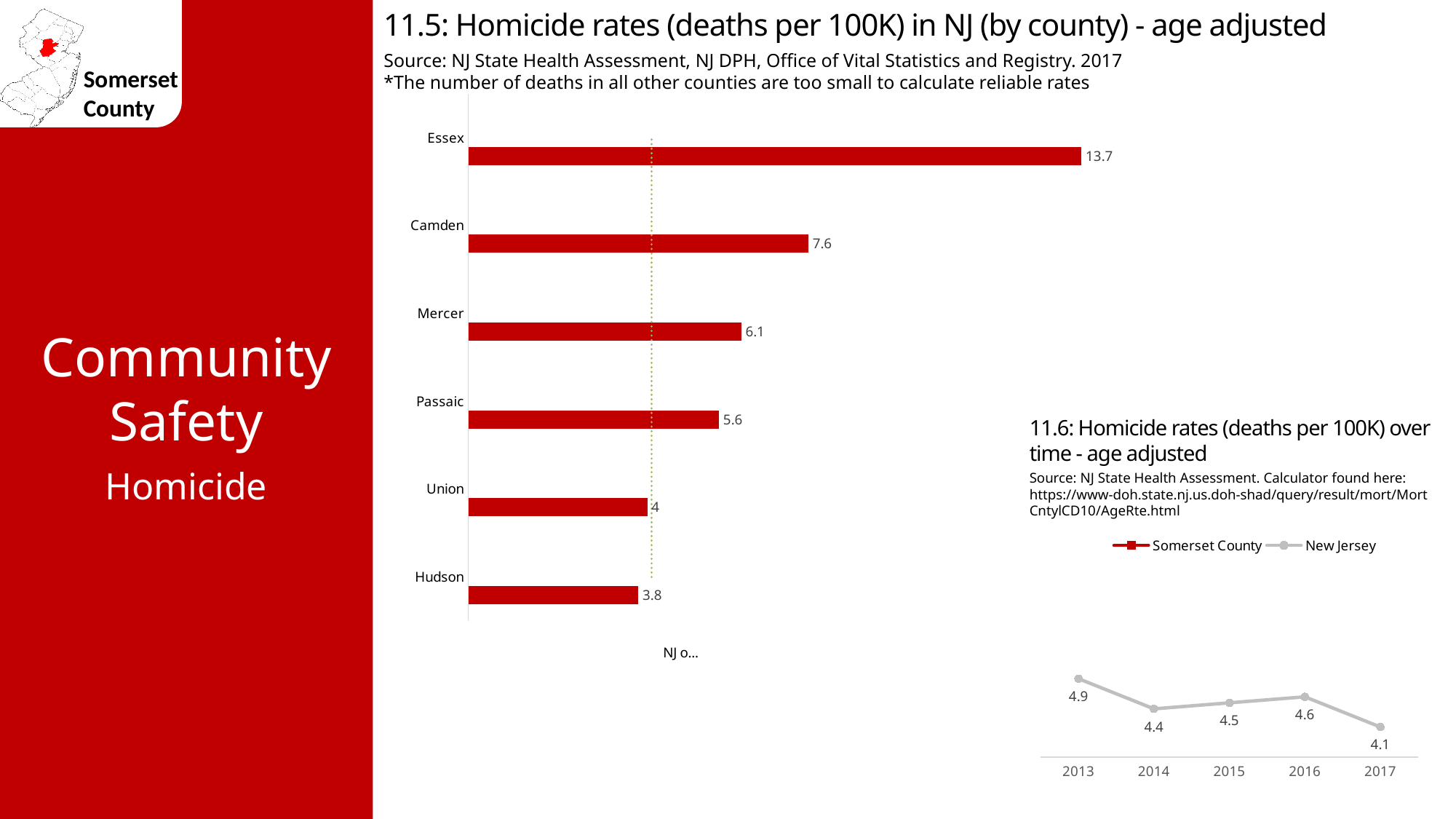
In chart 11.5 (homicide rates by county), what is the homicide rate for Hudson? 3.8 In chart 11.5 (homicide rates by county), which county has the lowest homicide rate? Hudson In chart 11.6 (homicide rates over time), what is the difference between the New Jersey rates in 2013 and 2017? 0.8 In chart 11.5 (homicide rates by county), which county has the highest homicide rate? Essex In chart 11.5 (homicide rates by county), which has a higher homicide rate, Passaic or Union? Passaic In chart 11.5 (homicide rates by county), what is the difference between the rates for Essex and Camden? 6.1 What kind of chart is chart 11.5 (homicide rates by county)? Bar chart In chart 11.6 (homicide rates over time), what is the New Jersey homicide rate in 2013? 4.9 In chart 11.5 (homicide rates by county), how many counties are shown? 6 In chart 11.5 (homicide rates by county), what is the homicide rate for Essex? 13.7 In chart 11.5 (homicide rates by county), what is the homicide rate for Mercer? 6.1 In chart 11.6 (homicide rates over time), how many series does the legend list? 2